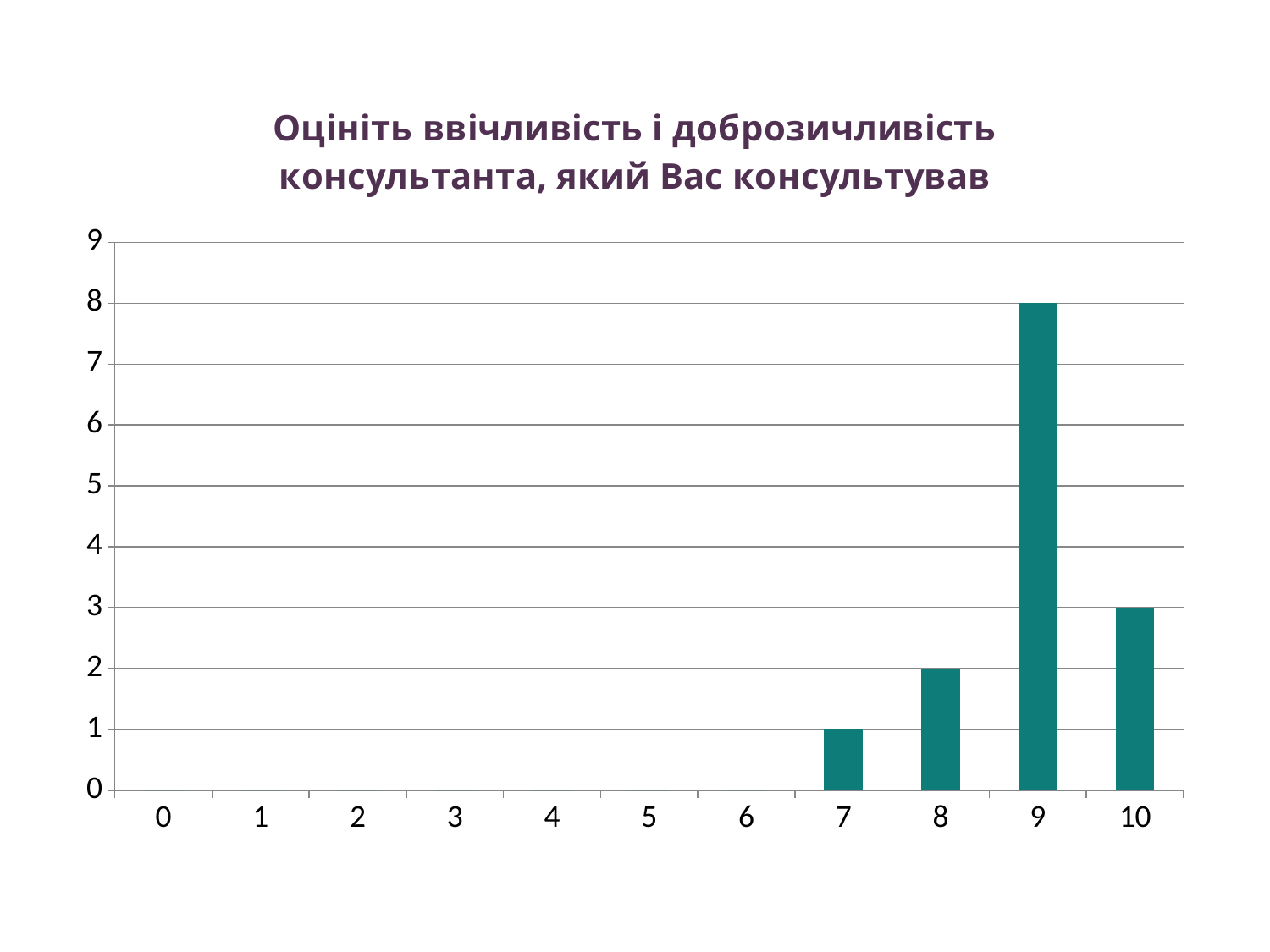
What is the value for category 7? 1 Is the value for category 9 greater or less than 5? greater Which is larger, the value for category 8 or the value for category 10? 10 Which category has the highest value? 9 What is the value for category 9? 8 Which of the categories with a visible bar has the lowest value? 7 How many categories are shown on the x axis? 11 What is the value for category 10? 3 What is the title of the chart? Оцініть ввічливість і доброзичливість консультанта, який Вас консультував What type of chart is shown on the slide? bar chart What is the difference between the values for category 9 and category 10? 5 What is the value for category 8? 2